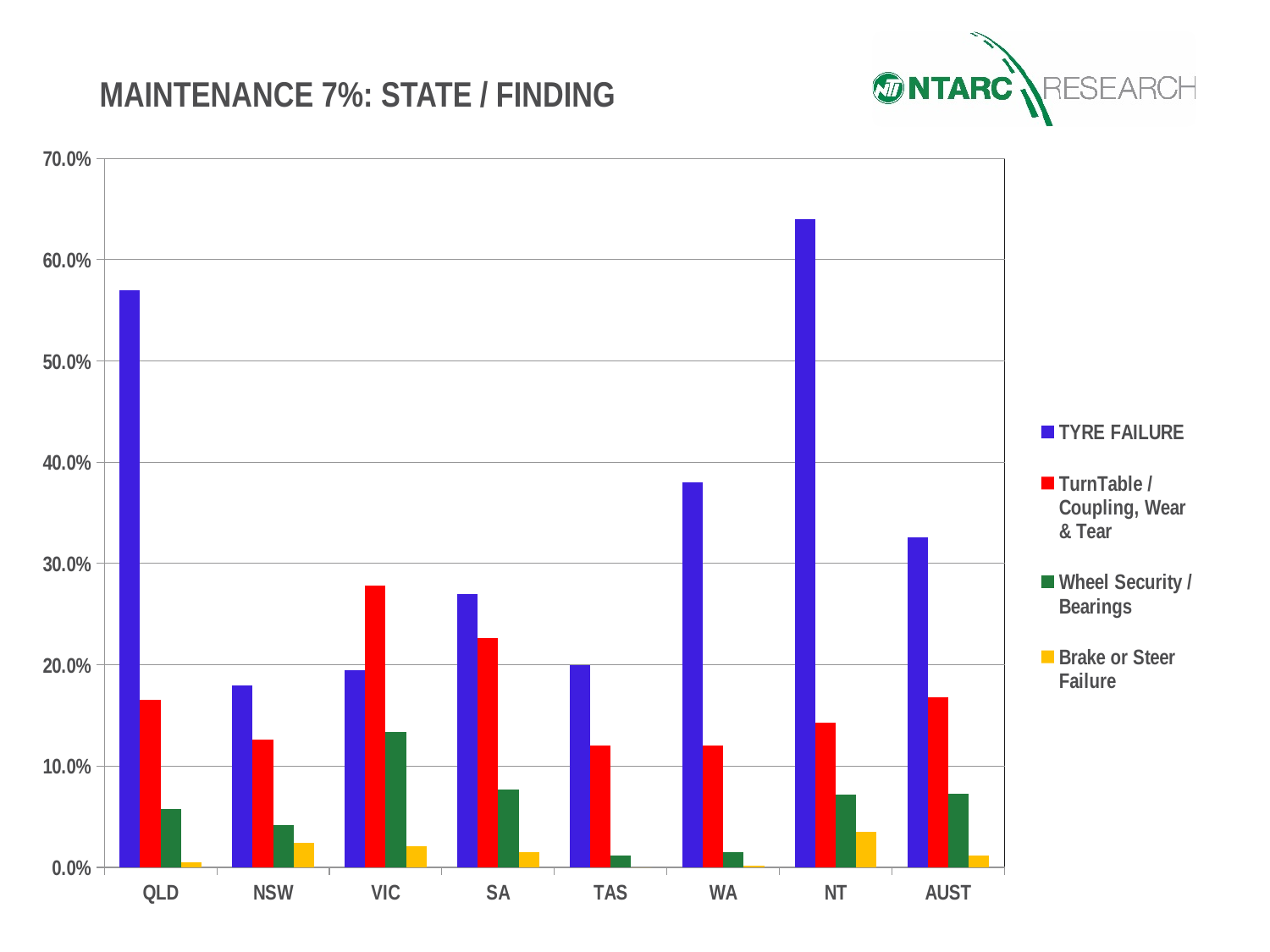
Which category has the highest TurnTable / Coupling, Wear & Tear value? VIC For VIC, which is larger: TYRE FAILURE or TurnTable / Coupling, Wear & Tear? TurnTable / Coupling, Wear & Tear Which category has the highest Wheel Security / Bearings value? VIC Is the TYRE FAILURE value for WA greater or less than 40.0%? less How many series does the legend list? 4 What kind of chart is shown on the slide? Bar chart Which category has the highest Brake or Steer Failure value? NT Is the TYRE FAILURE value for QLD greater or less than 50.0%? greater Is the TurnTable / Coupling, Wear & Tear value for VIC greater or less than 20.0%? greater How many categories are shown along the x axis? 8